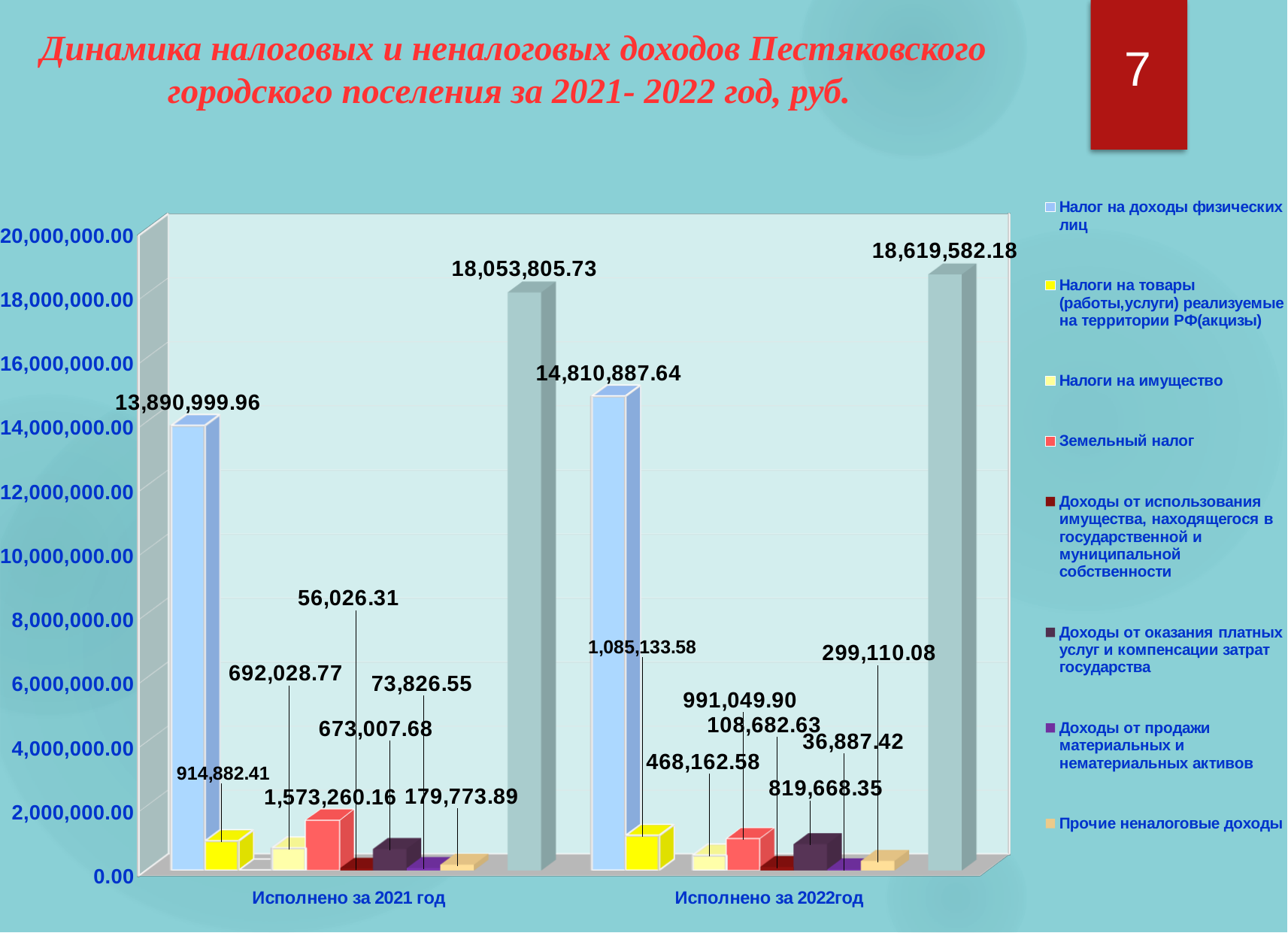
Which legend series has the highest value in the Исполнено за 2021 год group? Налог на доходы физических лиц Which year has the larger value for Налог на доходы физических лиц, 2021 or 2022? 2022 What is the value labelled on the tallest bar in the Исполнено за 2022год group? 18,619,582.18 Is the value for Налог на доходы физических лиц in 2022 greater or less than 14,000,000.00? greater How many series does the legend list? 8 By how much did Налог на доходы физических лиц increase from 2021 to 2022? 919,887.68 What is the value of Налог на доходы физических лиц for Исполнено за 2022год? 14,810,887.64 What is the value of Налог на доходы физических лиц for Исполнено за 2021 год? 13,890,999.96 What is the value labelled on the tallest bar in the Исполнено за 2021 год group? 18,053,805.73 How many categories (year groups) are shown on the x axis? 2 What kind of chart is shown on the slide? bar chart What is the value of Земельный налог for Исполнено за 2021 год? 1,573,260.16